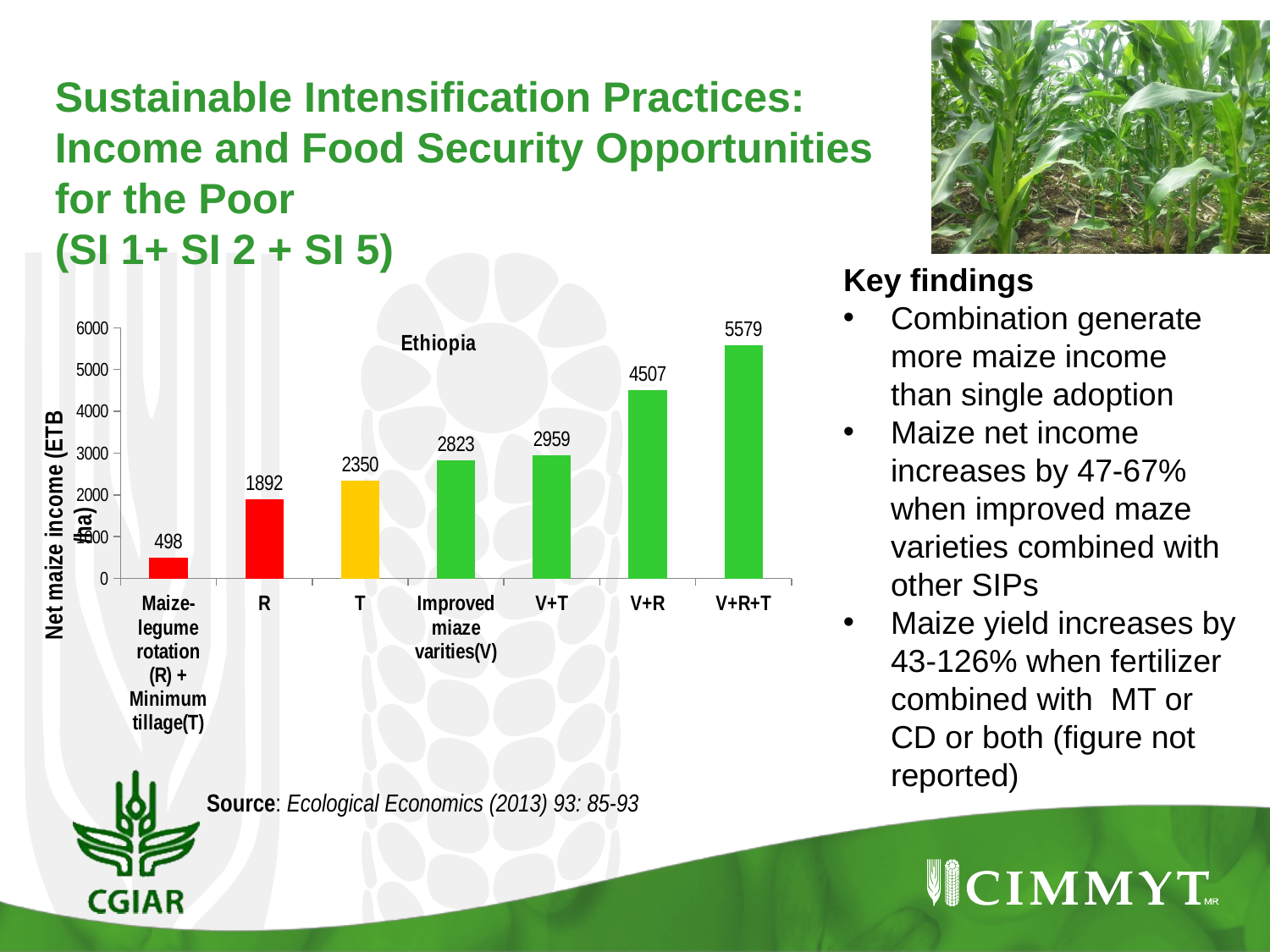
Which country is named in the chart? Ethiopia Which category has the highest net maize income? V+R+T What is the net maize income for Improved miaze varities(V)? 2823 What is the net maize income for R? 1892 What is the difference in net maize income between V+R and V+T? 1548 What kind of chart is shown on the slide? bar chart Which category has the lowest net maize income? Maize-legume rotation (R) + Minimum tillage(T) Do the values generally rise or fall from left to right along the x axis? rise Which has a higher net maize income, T or R? T How many categories are shown on the x axis of the chart? 7 What is the net maize income for V+R+T? 5579 Is the value for V+R greater or less than 4000? greater